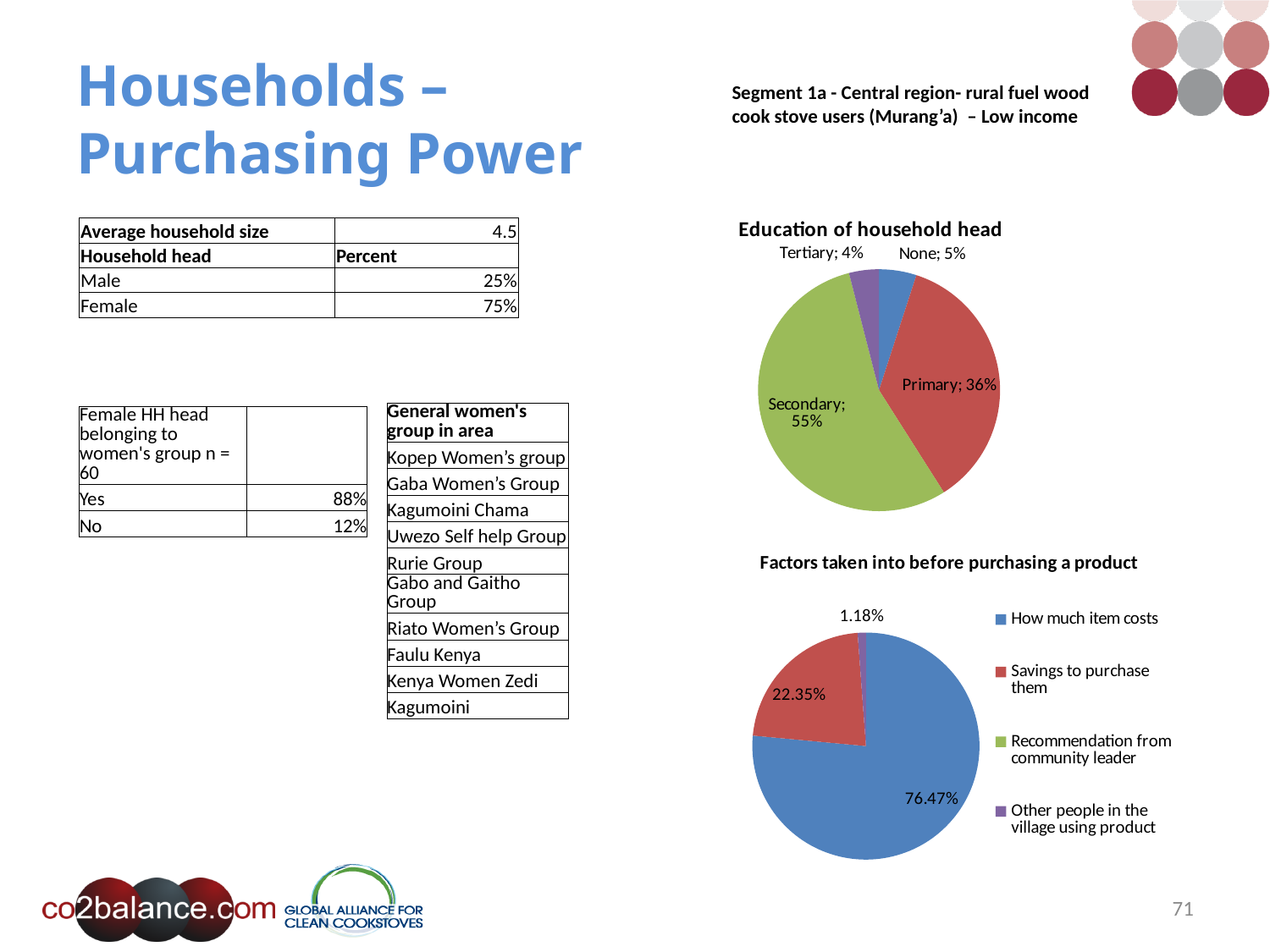
In the 'Education of household head' chart, what percentage of household heads have no education? 5% In the 'Education of household head' chart, how many slices does the pie have? 4 In the 'Factors taken into before purchasing a product' chart, how many entries does the legend list? 4 In the 'Education of household head' chart, what is the difference in percentage points between Secondary and Primary? 19 In the 'Education of household head' chart, what percentage of household heads have primary education? 36% What type of chart is 'Factors taken into before purchasing a product'? Pie chart In the 'Education of household head' chart, which education level has the largest share? Secondary In the 'Education of household head' chart, which education level has the smallest share? Tertiary In the 'Factors taken into before purchasing a product' chart, what share is shown for 'How much item costs'? 76.47% In the 'Education of household head' chart, what percentage of household heads have secondary education? 55% In the 'Factors taken into before purchasing a product' chart, which is larger: 'How much item costs' or 'Savings to purchase them'? How much item costs In the 'Factors taken into before purchasing a product' chart, what share is shown for 'Savings to purchase them'? 22.35%